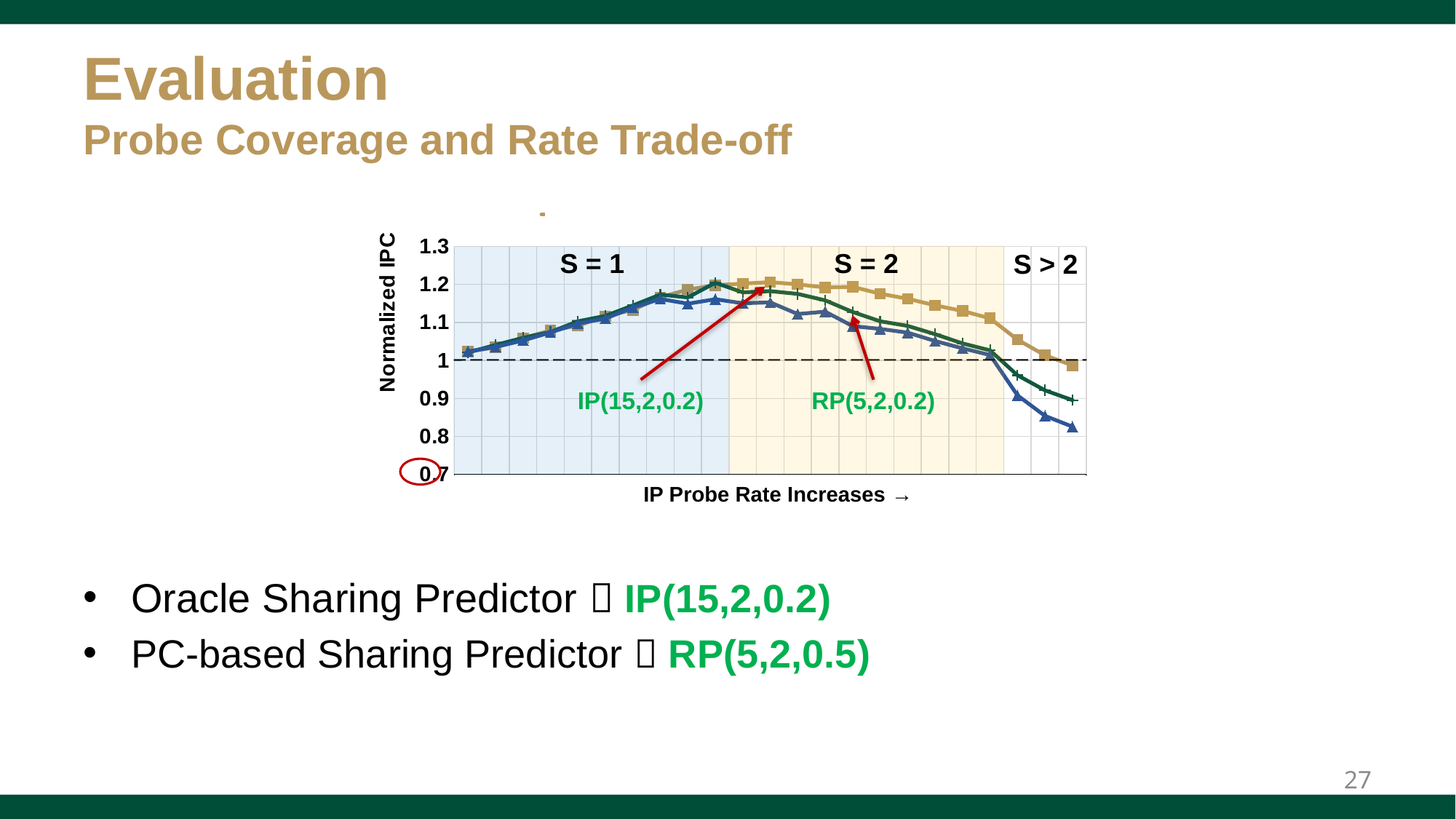
Do the plotted lines rise or fall as the IP probe rate increases toward the right end of the chart? fall How many lines are plotted on the chart? 3 What is the label of the y axis of the chart? Normalized IPC What is the label of the x axis of the chart? IP Probe Rate Increases → Is the final value of the blue triangle line greater or less than 0.8? greater Is the final value of the blue triangle line greater or less than 0.9? less What kind of chart is shown on the slide? line chart At the right end of the chart, which line is the lowest: the tan square line, the green plus line, or the blue triangle line? blue triangle line What is the highest value shown on the y axis of the chart? 1.3 Which configuration does the arrow pointing to the peak of the green line in the S = 1 region label? IP(15,2,0.2) At the right end of the chart, which line is the highest: the tan square line, the green plus line, or the blue triangle line? tan square line What is the lowest value shown on the y axis of the chart? 0.7